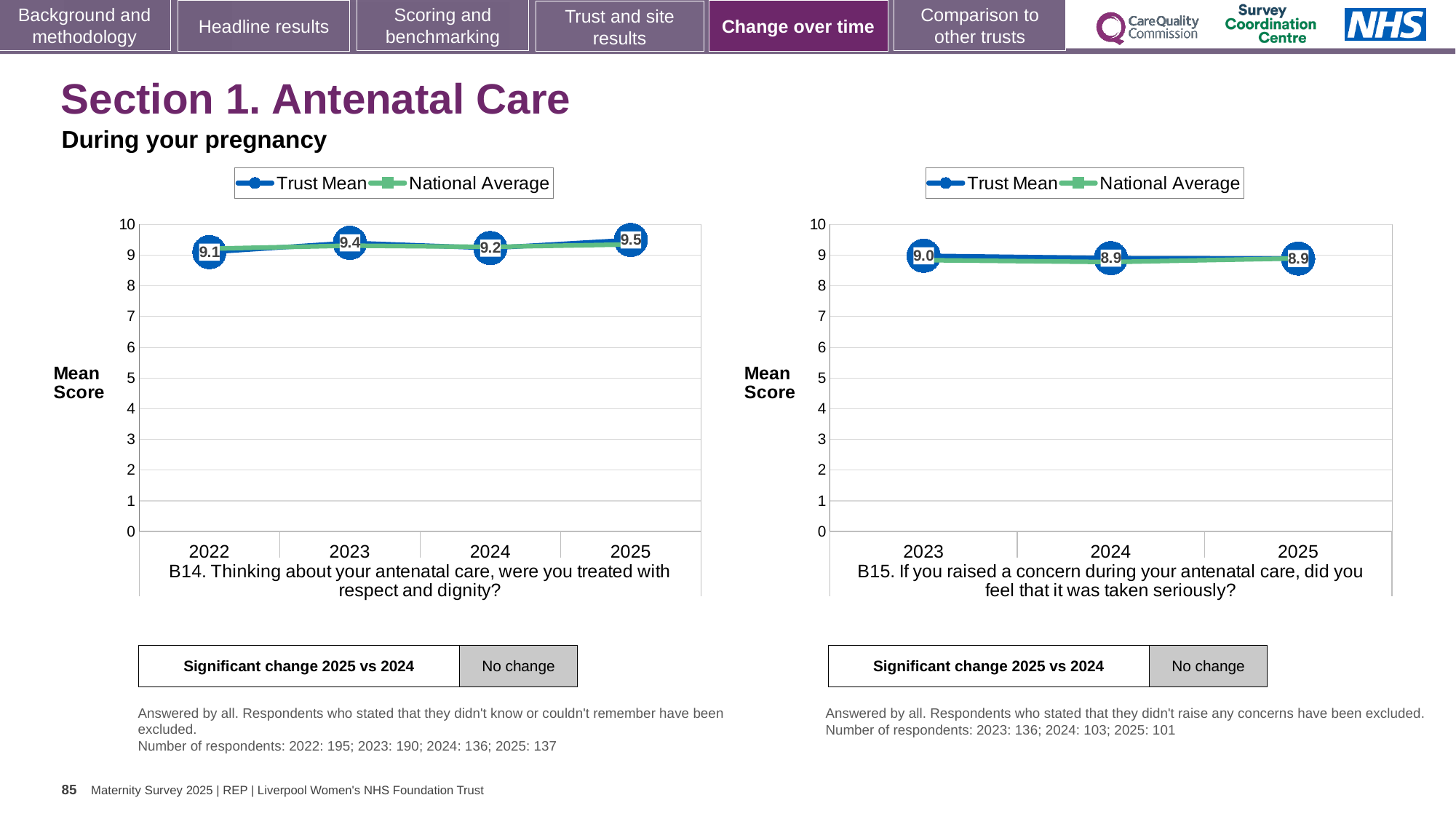
In the B14 chart on the left, which year has the highest Trust Mean score? 2025 In the B15 chart on the right, which year has the highest Trust Mean score? 2023 In the B14 chart on the left, is the Trust Mean score higher in 2023 or 2024? 2023 In the B15 chart on the right, what is the Trust Mean score for 2023? 9.0 In the B15 chart on the right, what is the difference between the Trust Mean scores for 2023 and 2025? 0.1 In the B14 chart on the left, which year has the lowest Trust Mean score? 2022 How many years are shown on the x axis of the B14 chart on the left? 4 In the B14 chart on the left, what is the Trust Mean score for 2023? 9.4 How many series does the legend of the B15 chart on the right list? 2 In the B15 chart on the right, is the National Average value for 2024 greater or less than 5? greater In the B14 chart on the left, what is the difference between the Trust Mean scores for 2025 and 2022? 0.4 In the B14 chart on the left, what is the Trust Mean score for 2025? 9.5